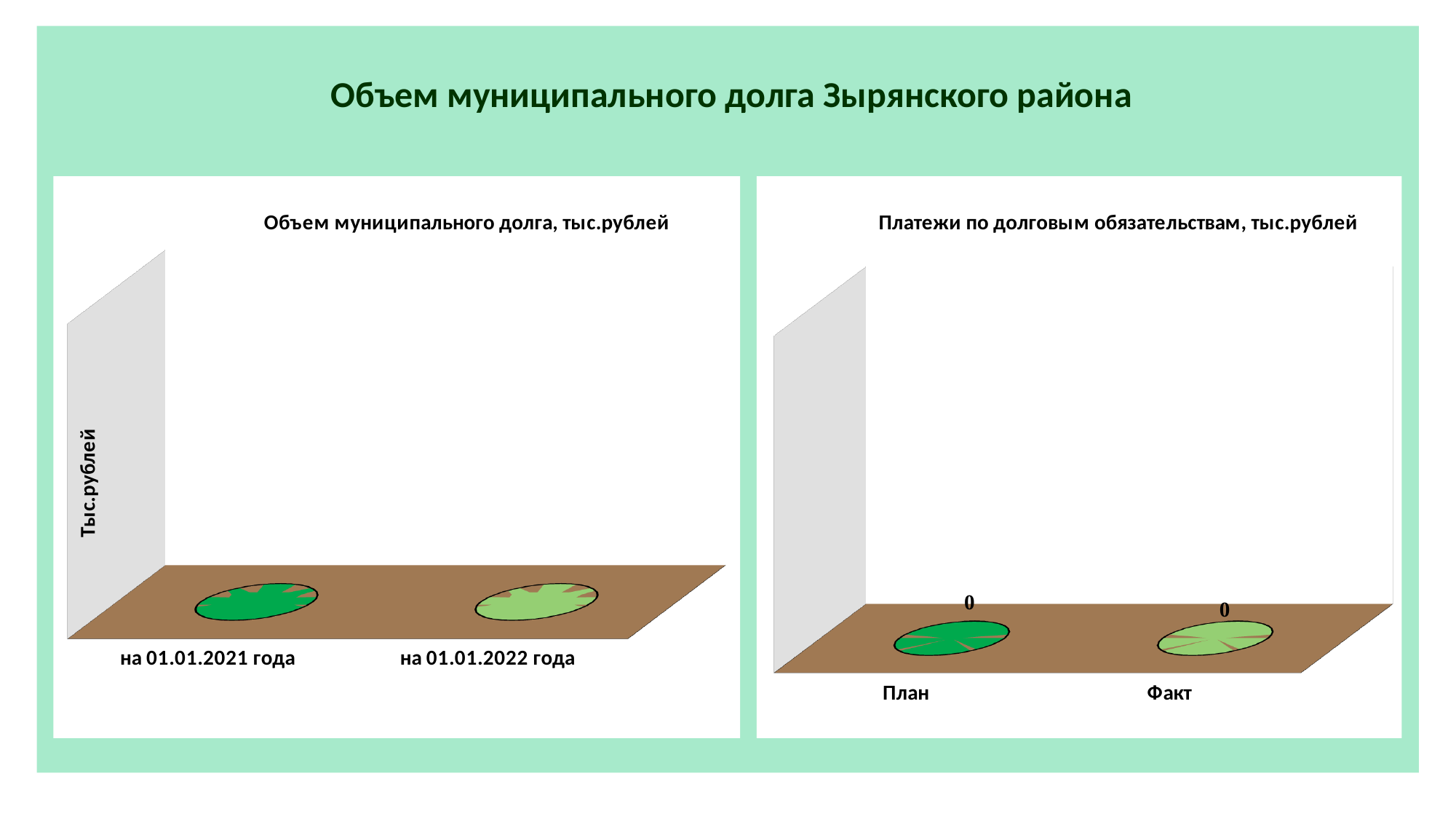
What is the title of the chart on the left side of the slide? Объем муниципального долга, тыс.рублей What kind of chart is the one on the right side of the slide? Bar chart In the chart titled "Платежи по долговым обязательствам, тыс.рублей", what is the value for Факт? 0 What kind of chart is the one on the left side of the slide? Bar chart What is the vertical axis label of the chart on the left side of the slide? Тыс.рублей How many categories are shown in the chart titled "Платежи по долговым обязательствам, тыс.рублей"? 2 How many categories are shown in the chart titled "Объем муниципального долга, тыс.рублей"? 2 In the chart titled "Платежи по долговым обязательствам, тыс.рублей", what is the value for План? 0 In the chart titled "Объем муниципального долга, тыс.рублей", what are the two category labels on the x axis? на 01.01.2021 года, на 01.01.2022 года In the chart titled "Платежи по долговым обязательствам, тыс.рублей", what is the difference between the values for План and Факт? 0